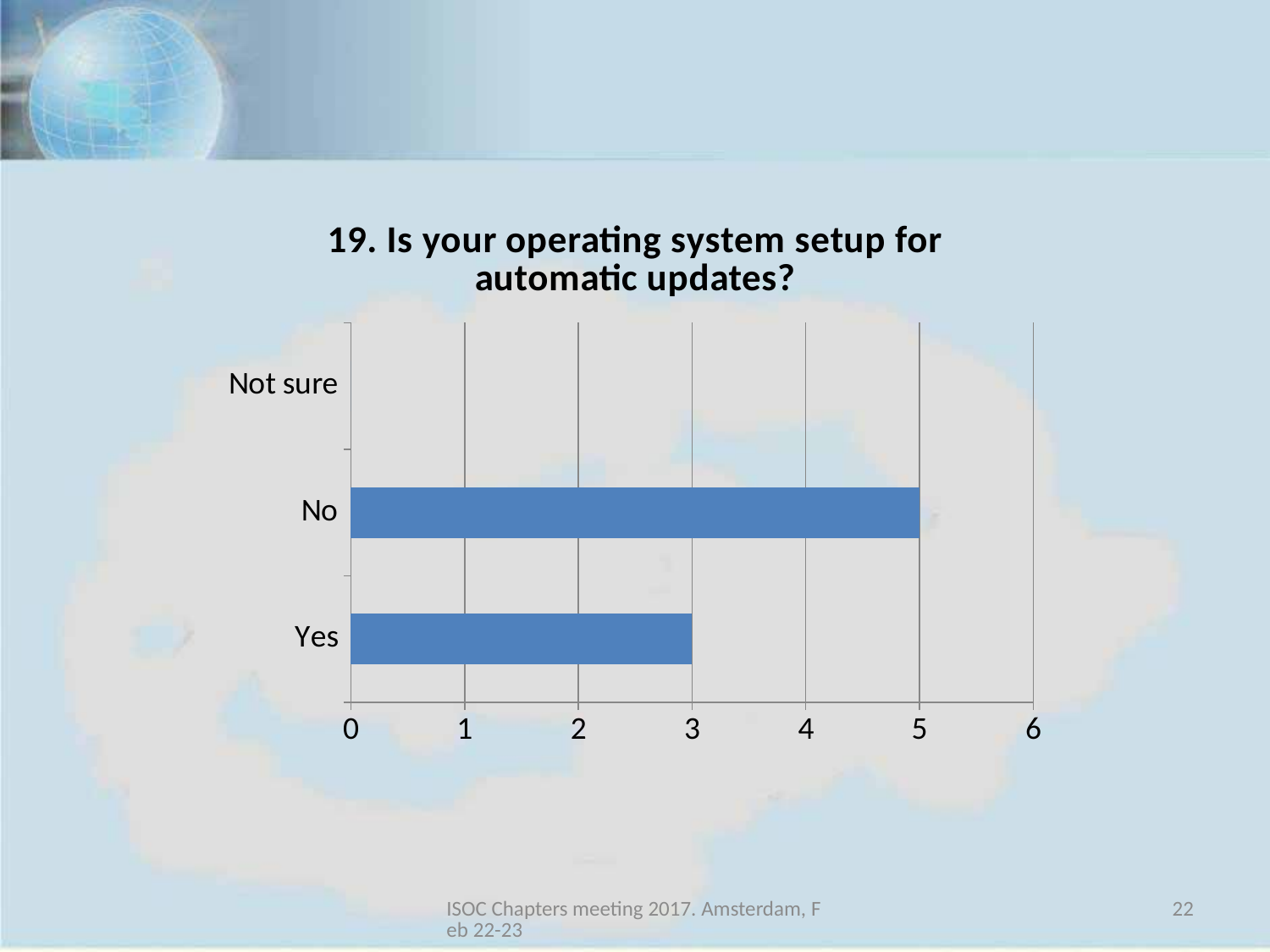
Which category has the lowest value? Not sure Is the value for "Yes" greater or less than 4? less What is the difference between the values for "No" and "Yes"? 2 What is the highest value shown on the horizontal axis? 6 How many categories are shown on the chart? 3 What kind of chart is shown on the slide? Bar chart What is the value for "No"? 5 What is the title of the chart? 19. Is your operating system setup for automatic updates? Is the value for "No" greater or less than 4? greater What is the value for "Yes"? 3 Which is larger, the value for "Yes" or the value for "No"? No Which category has the highest value? No